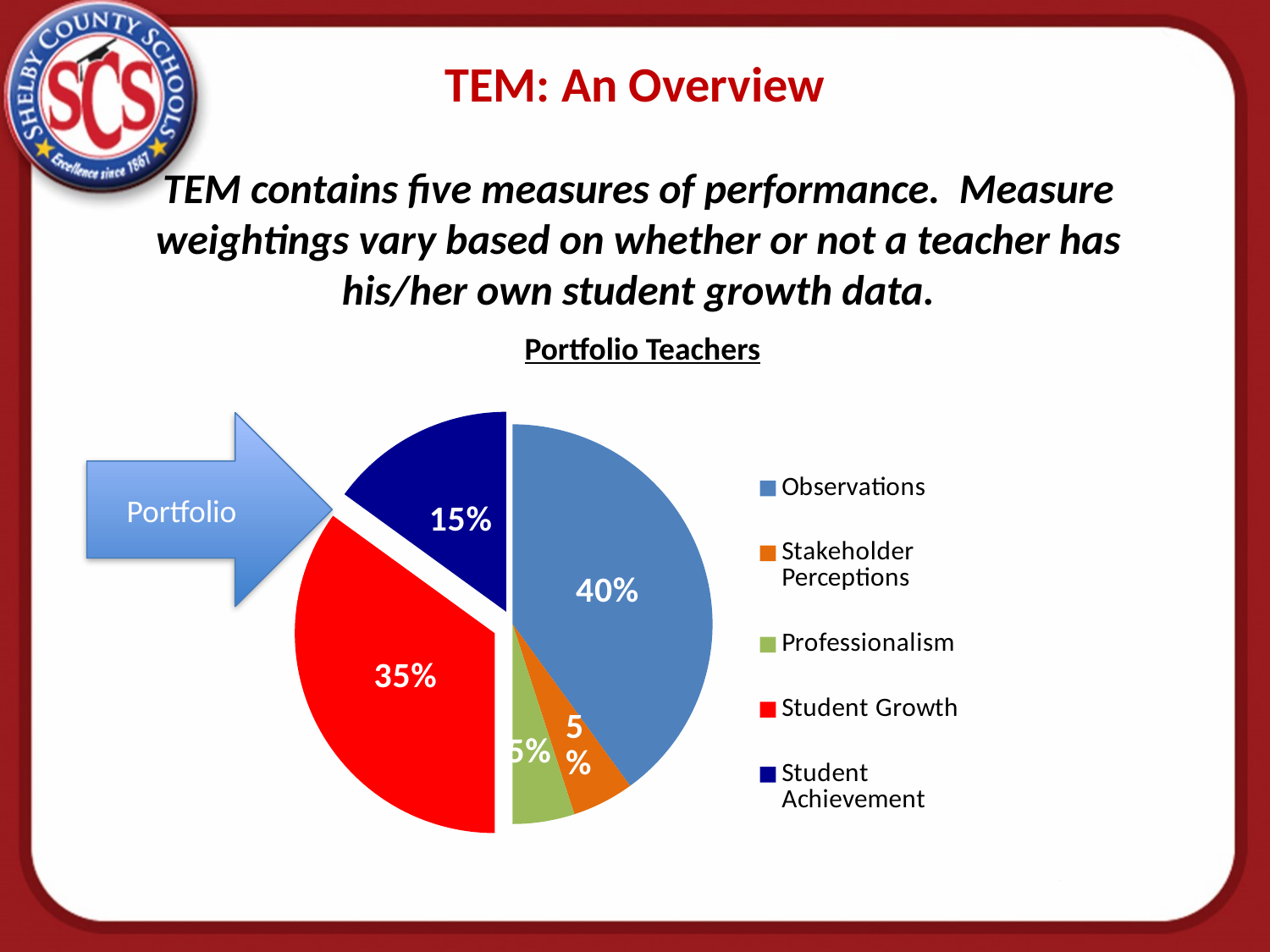
Which is larger, the Student Growth slice or the Student Achievement slice? Student Growth What is the title of the chart? Portfolio Teachers Which measure has the largest slice of the pie? Observations What is the difference between the Observations share and the Student Growth share? 5% What share of the pie does Stakeholder Perceptions take? 5% How many slices does the pie chart have? 5 How many entries does the legend list? 5 What share of the pie does Student Growth take? 35% What colour is the Student Growth slice? Red What share of the pie does Observations take? 40% What kind of chart is shown on the slide? Pie chart What share of the pie does Student Achievement take? 15%